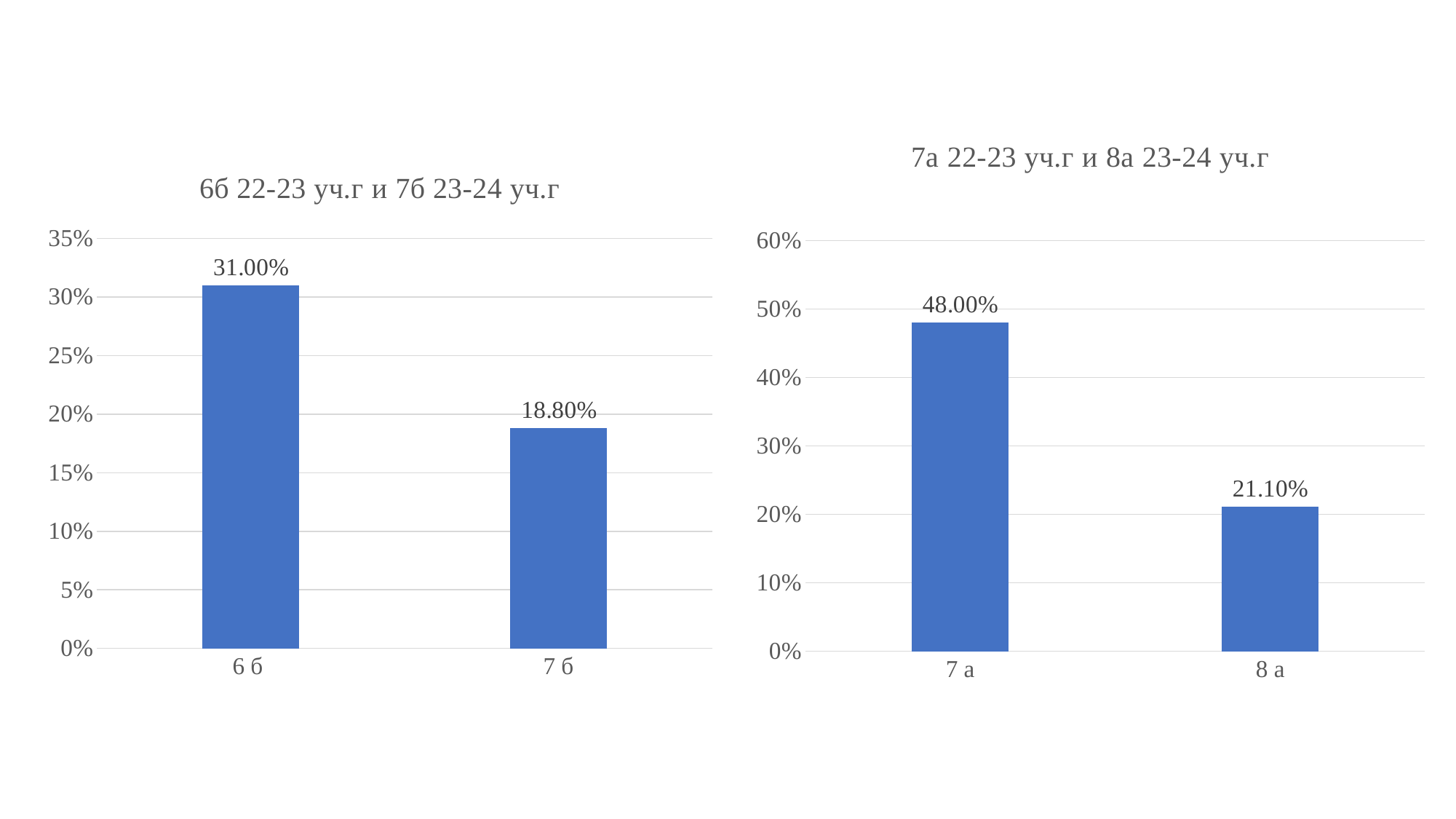
In the left chart, what is the difference between the values for 6 б and 7 б? 12.20% In the right chart, which is larger: the value for 7 а or the value for 8 а? 7 а In the right chart titled "7а 22-23 уч.г и 8а 23-24 уч.г", what is the value for 7 а? 48.00% In the right chart, which category has the lowest value? 8 а In the right chart titled "7а 22-23 уч.г и 8а 23-24 уч.г", what is the value for 8 а? 21.10% In the left chart, do the values rise or fall from 6 б to 7 б? Fall In the right chart, what is the difference between the values for 7 а and 8 а? 26.90% In the left chart, which category has the highest value? 6 б In the left chart titled "6б 22-23 уч.г и 7б 23-24 уч.г", what is the value for 6 б? 31.00% In the left chart, how many categories are shown on the x axis? 2 In the left chart titled "6б 22-23 уч.г и 7б 23-24 уч.г", what is the value for 7 б? 18.80% What type of chart is the right chart titled "7а 22-23 уч.г и 8а 23-24 уч.г"? Bar chart